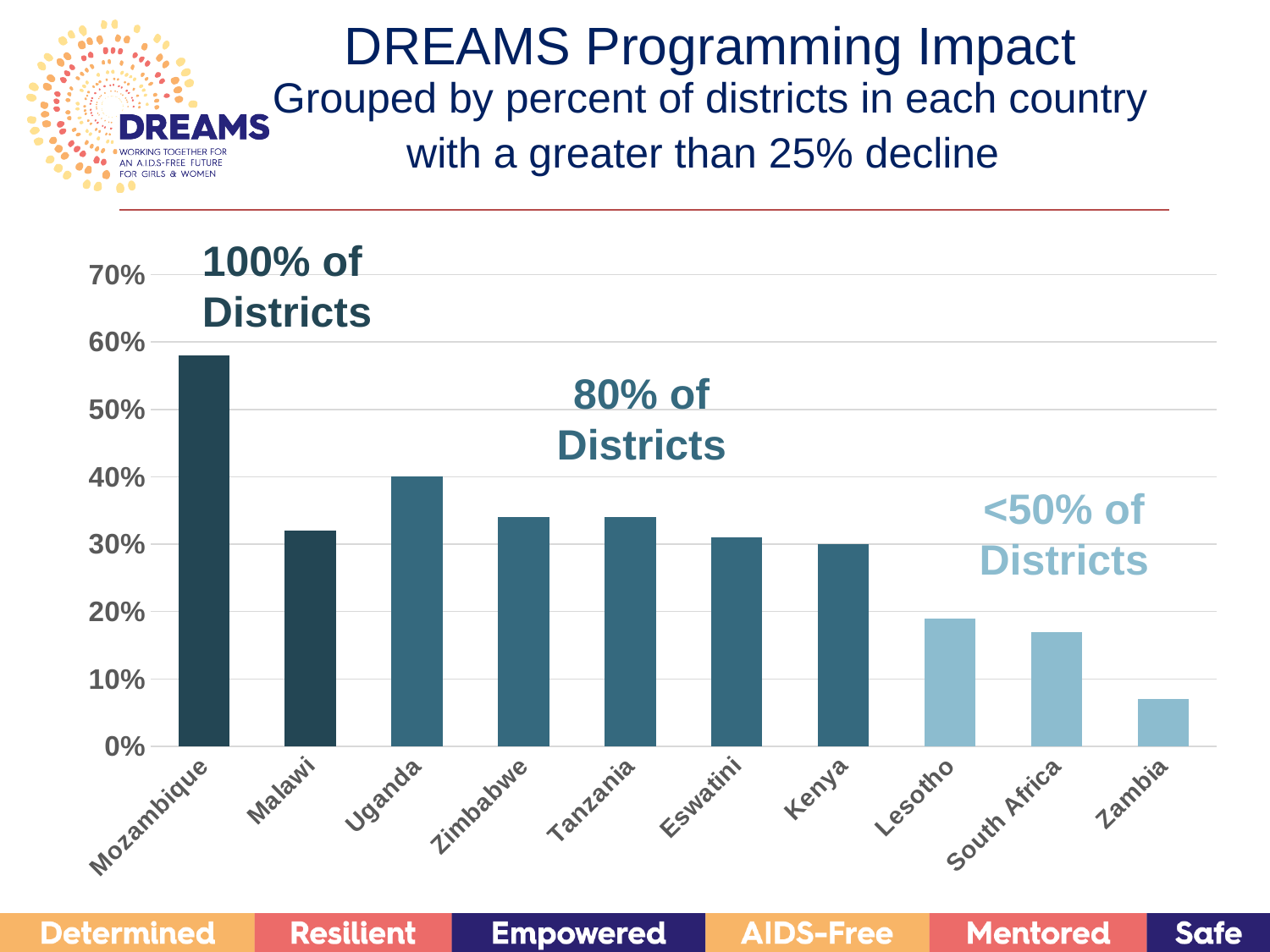
What kind of chart is shown on the slide? bar chart Which has the larger value, Mozambique or Malawi? Mozambique Is the value for Uganda greater or less than 30%? greater Do the bar values generally rise or fall from left to right across the x axis? fall Which has the larger value, South Africa or Uganda? Uganda What is the title of the chart on the slide? DREAMS Programming Impact Is the value for Zambia greater or less than 10%? less Which country has the lowest bar in the chart? Zambia Which country has the highest bar in the chart? Mozambique Is the value for Mozambique greater or less than 50%? greater How many countries are shown on the x axis of the chart? 10